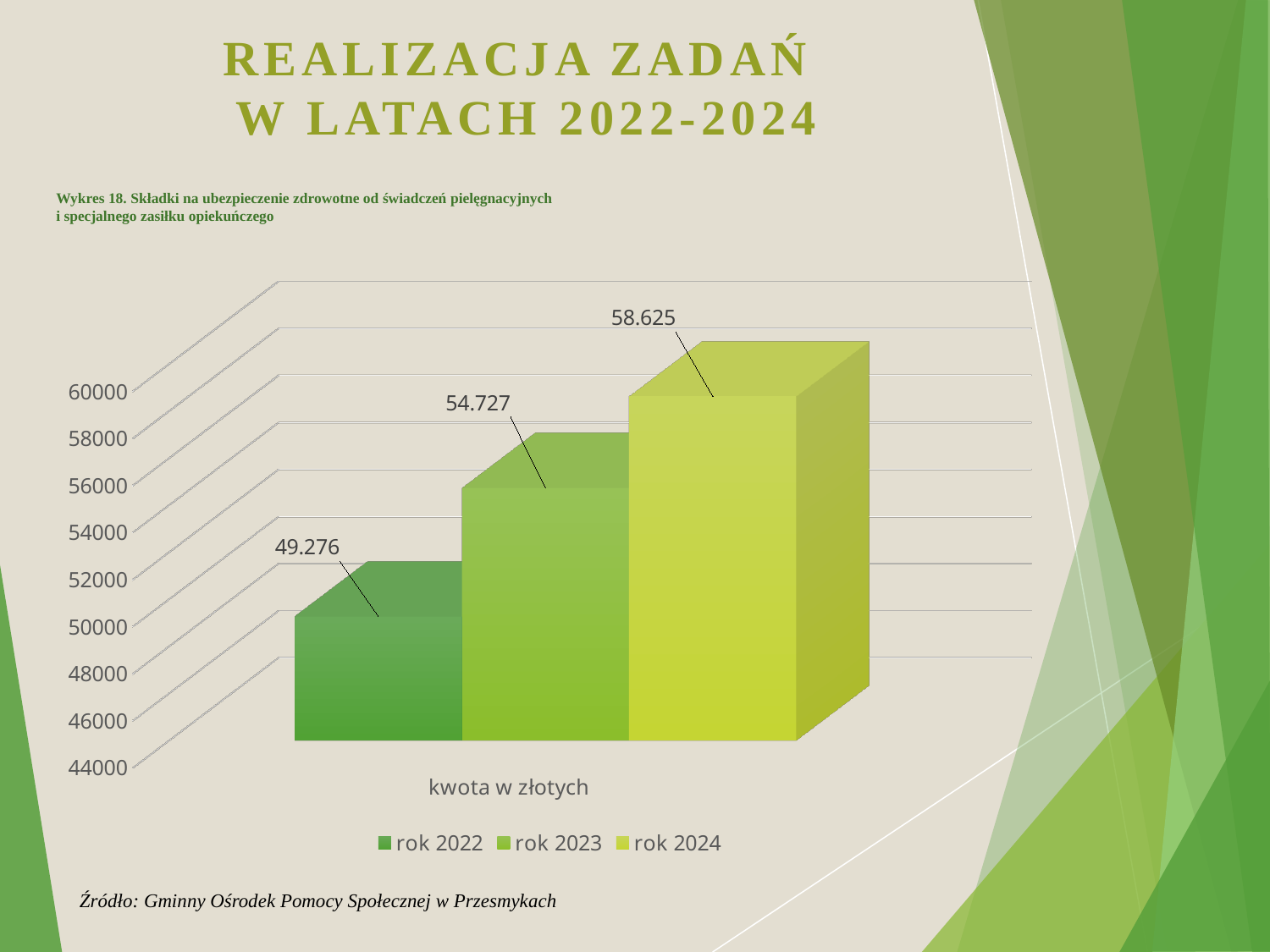
What is the value for rok 2023? 54.727 What kind of chart is shown on the slide? bar chart How many series does the legend list? 3 What is the difference between the values for rok 2024 and rok 2022? 9.349 What is the value for rok 2024? 58.625 Which is larger, the value for rok 2023 or rok 2024? rok 2024 Is the value for rok 2022 greater or less than 50000? less What is the difference between the values for rok 2023 and rok 2022? 5.451 Which year has the highest value? rok 2024 Do the values rise or fall from rok 2022 to rok 2024? rise What is the value for rok 2022? 49.276 Which year has the lowest value? rok 2022